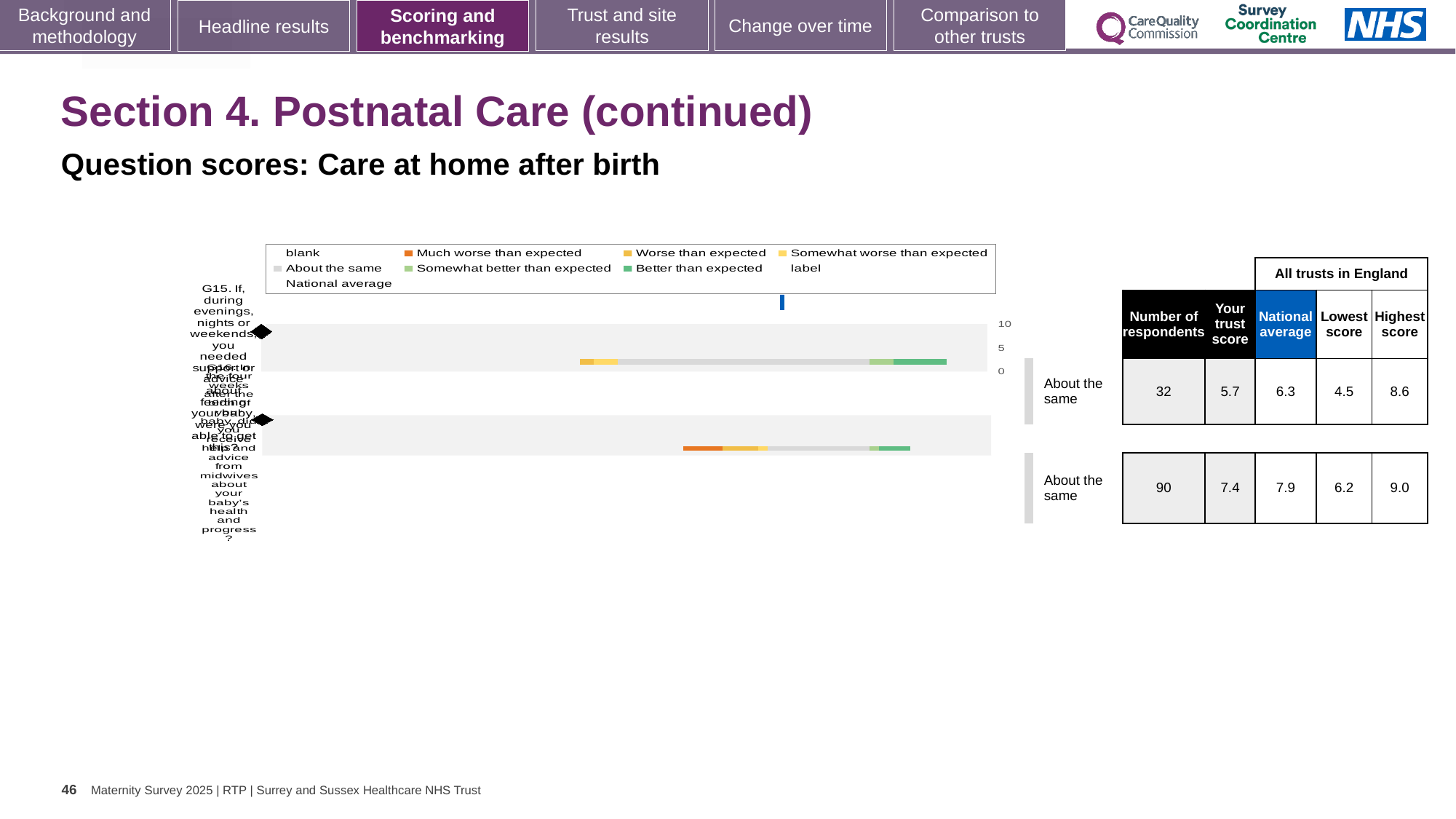
In the table, what is the difference between the highest and lowest score in the second row? 2.8 Which row of the table has the higher 'Your trust score', the first or the second? the second In the table, what is the highest score in the second row? 9.0 In the table, what is 'Your trust score' in the second row? 7.4 In the table, what is the number of respondents in the second row? 90 What benchmark category is shown next to both rows of the table? About the same How many question bars are plotted in the chart? 2 In the table, what is the national average in the first row? 6.3 In the table, what is the number of respondents in the first row? 32 In the table, what is the lowest score in the first row? 4.5 In the table, what is the difference between the national average and your trust score in the first row? 0.6 What kind of chart is shown on the slide? bar chart